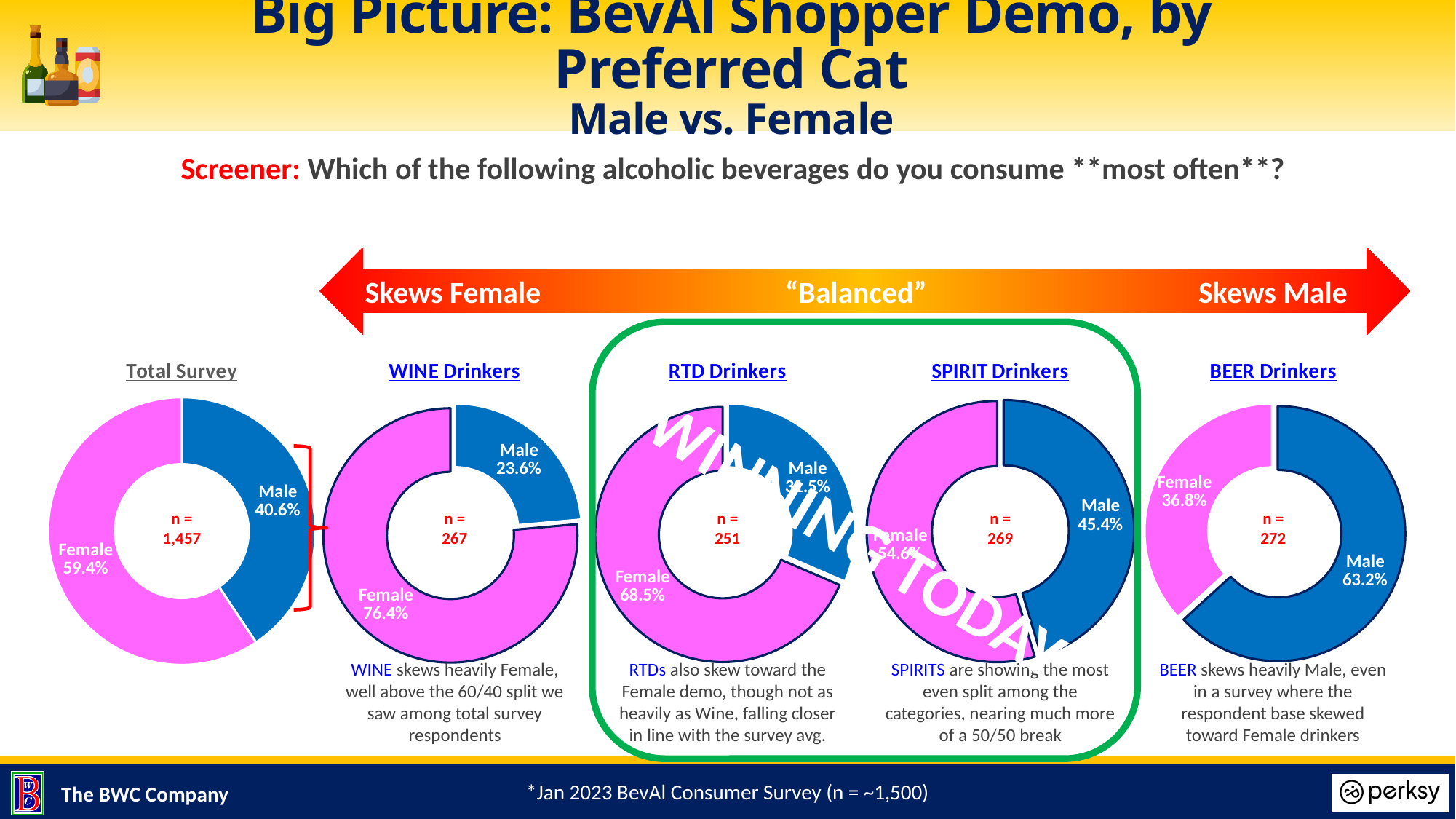
In the Total Survey chart, what share of respondents are Female? 59.4% What kind of chart is used for the Total Survey? Donut (pie) chart In the BEER Drinkers chart, what percentage are Male? 63.2% In the Total Survey chart, what is the sample size shown in the centre? n = 1,457 In the SPIRIT Drinkers chart, what percentage are Male? 45.4% In the BEER Drinkers chart, which is larger, the Male share or the Female share? Male In the WINE Drinkers chart, what percentage are Male? 23.6% In the WINE Drinkers chart, what percentage are Female? 76.4% How many donut charts are shown on the slide? 5 In the RTD Drinkers chart, what percentage are Female? 68.5% In the WINE Drinkers chart, what is the difference between the Female and Male shares? 52.8% In the BEER Drinkers chart, what is the sample size shown in the centre? n = 272